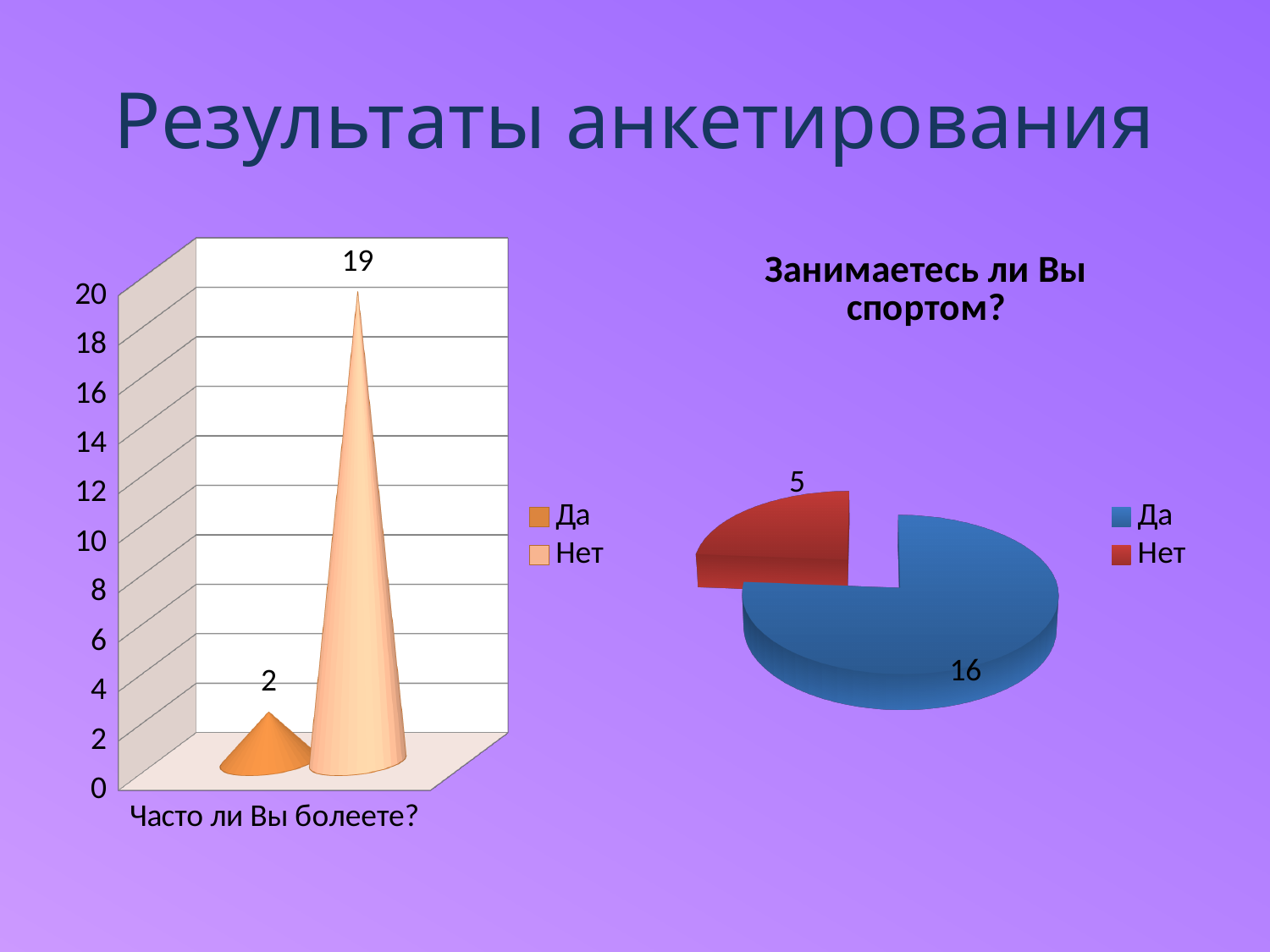
What kind of chart is the right chart 'Занимаетесь ли Вы спортом?'? Pie chart In the left chart (Часто ли Вы болеете?), what is the difference between the Нет and Да values? 17 In the left chart (Часто ли Вы болеете?), what is the maximum value shown on the vertical axis? 20 In the pie chart 'Занимаетесь ли Вы спортом?', what is the total of all slices? 21 In the left chart (Часто ли Вы болеете?), what is the value for Нет? 19 In the left chart (Часто ли Вы болеете?), what is the value for Да? 2 In the pie chart 'Занимаетесь ли Вы спортом?', which slice is the largest? Да What kind of chart is the left chart (Часто ли Вы болеете?)? Bar chart In the left chart (Часто ли Вы болеете?), how many series does the legend list? 2 In the pie chart 'Занимаетесь ли Вы спортом?', what is the value for Нет? 5 In the pie chart 'Занимаетесь ли Вы спортом?', what is the value for Да? 16 In the left chart (Часто ли Вы болеете?), which series has the higher value, Да or Нет? Нет